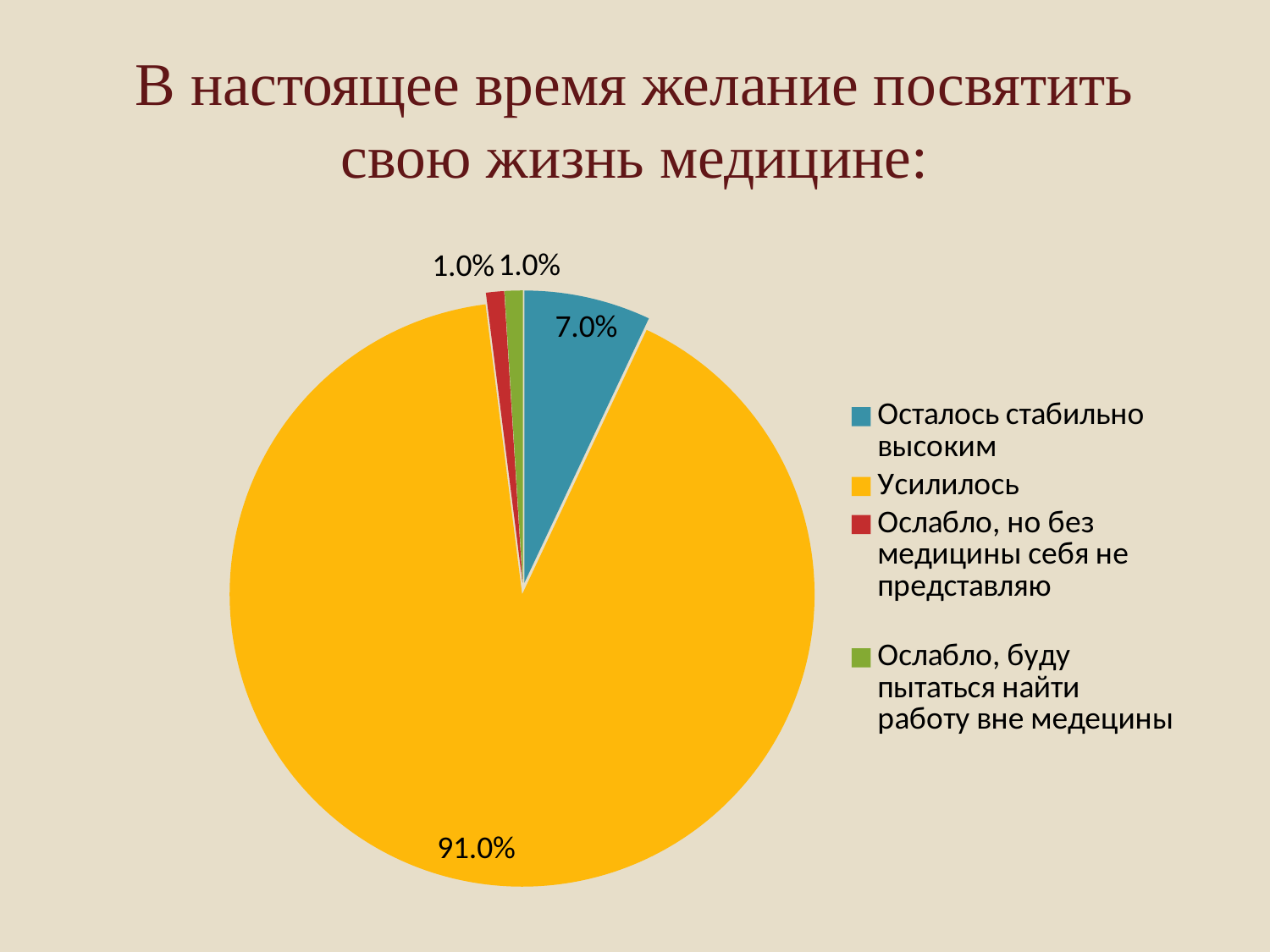
What colour is the slice for "Усилилось"? yellow What kind of chart is shown on the slide? pie chart What is the value for "Ослабло, но без медицины себя не представляю"? 1.0% What is the difference between the values for "Усилилось" and "Осталось стабильно высоким"? 84.0% What is the title of the slide? В настоящее время желание посвятить свою жизнь медицине: How many entries does the legend list? 4 What is the value for "Ослабло, буду пытаться найти работу вне медецины"? 1.0% What share of the pie does "Усилилось" take? 91.0% How many slices does the pie chart have? 4 Which is larger: the value for "Осталось стабильно высоким" or the value for "Ослабло, но без медицины себя не представляю"? Осталось стабильно высоким What is the value for "Осталось стабильно высоким"? 7.0% Which category has the largest slice of the pie? Усилилось